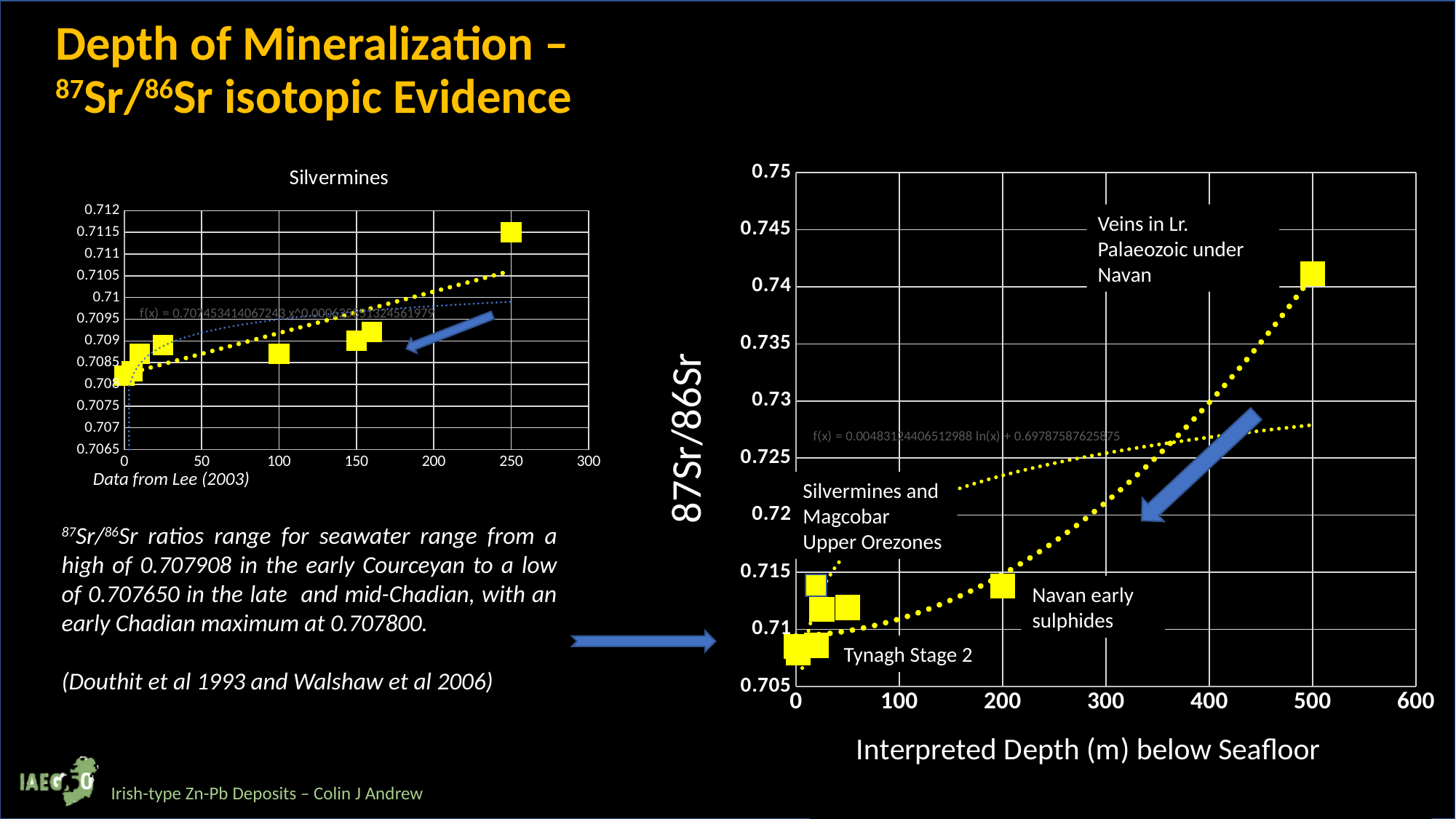
In the chart on the right, is the value for the point labelled 'Veins in Lr. Palaeozoic under Navan' greater or less than 0.735? greater In the chart on the right, is the value for the points labelled 'Tynagh Stage 2' greater or less than 0.71? less What kind of chart is the large chart on the right of the slide? scatter chart In the chart on the right, do the 87Sr/86Sr values rise or fall as interpreted depth increases? rise What kind of chart is the Silvermines chart on the left of the slide? scatter chart In the Silvermines chart, is the value of the point at the far right (near 250 on the x axis) greater or less than 0.711? greater In the chart on the right, which labelled group has the highest 87Sr/86Sr value? Veins in Lr. Palaeozoic under Navan What is the x-axis title of the chart on the right of the slide? Interpreted Depth (m) below Seafloor What is the title of the chart on the left of the slide? Silvermines In the chart on the right, which labelled group has the lowest 87Sr/86Sr value? Tynagh Stage 2 In the chart on the right, which has the larger 87Sr/86Sr value: 'Navan early sulphides' or 'Veins in Lr. Palaeozoic under Navan'? Veins in Lr. Palaeozoic under Navan